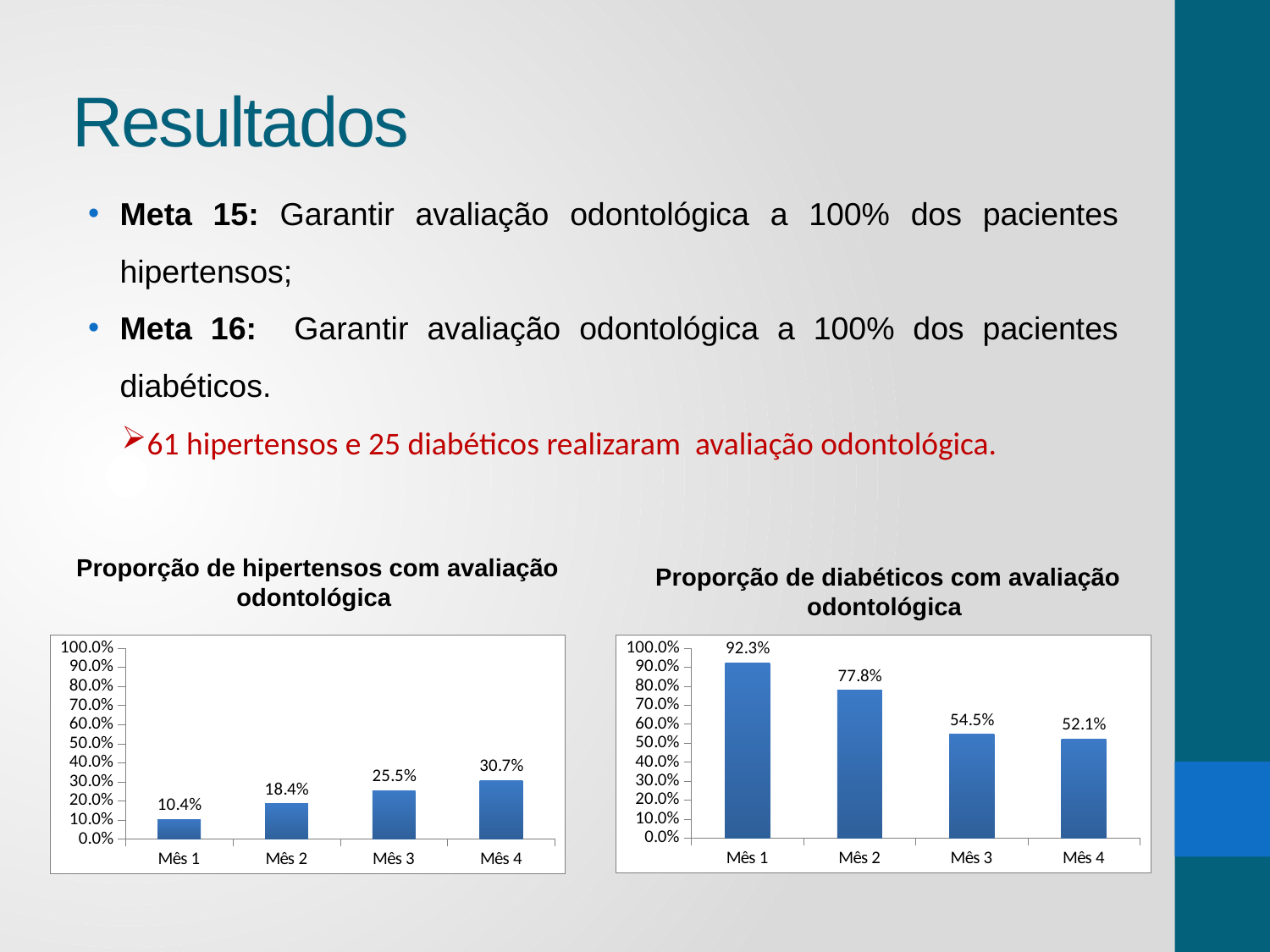
In the chart 'Proporção de hipertensos com avaliação odontológica', is the value for Mês 4 greater or less than 50.0%? less In the chart 'Proporção de hipertensos com avaliação odontológica', which month has the highest value? Mês 4 In the chart 'Proporção de hipertensos com avaliação odontológica', what is the value for Mês 3? 25.5% In the chart 'Proporção de hipertensos com avaliação odontológica', do the values rise or fall from Mês 1 to Mês 4? Rise How many months are shown in the chart 'Proporção de diabéticos com avaliação odontológica'? 4 In the chart 'Proporção de diabéticos com avaliação odontológica', do the values rise or fall from Mês 1 to Mês 4? Fall In the chart 'Proporção de diabéticos com avaliação odontológica', which month has the lowest value? Mês 4 In the chart 'Proporção de diabéticos com avaliação odontológica', which is larger: the value for Mês 1 or Mês 2? Mês 1 In the chart 'Proporção de diabéticos com avaliação odontológica', what is the difference between the values for Mês 1 and Mês 3? 37.8% What kind of chart is 'Proporção de hipertensos com avaliação odontológica'? Bar chart In the chart 'Proporção de diabéticos com avaliação odontológica', what is the value for Mês 2? 77.8% In the chart 'Proporção de hipertensos com avaliação odontológica', what is the difference between the values for Mês 4 and Mês 1? 20.3%